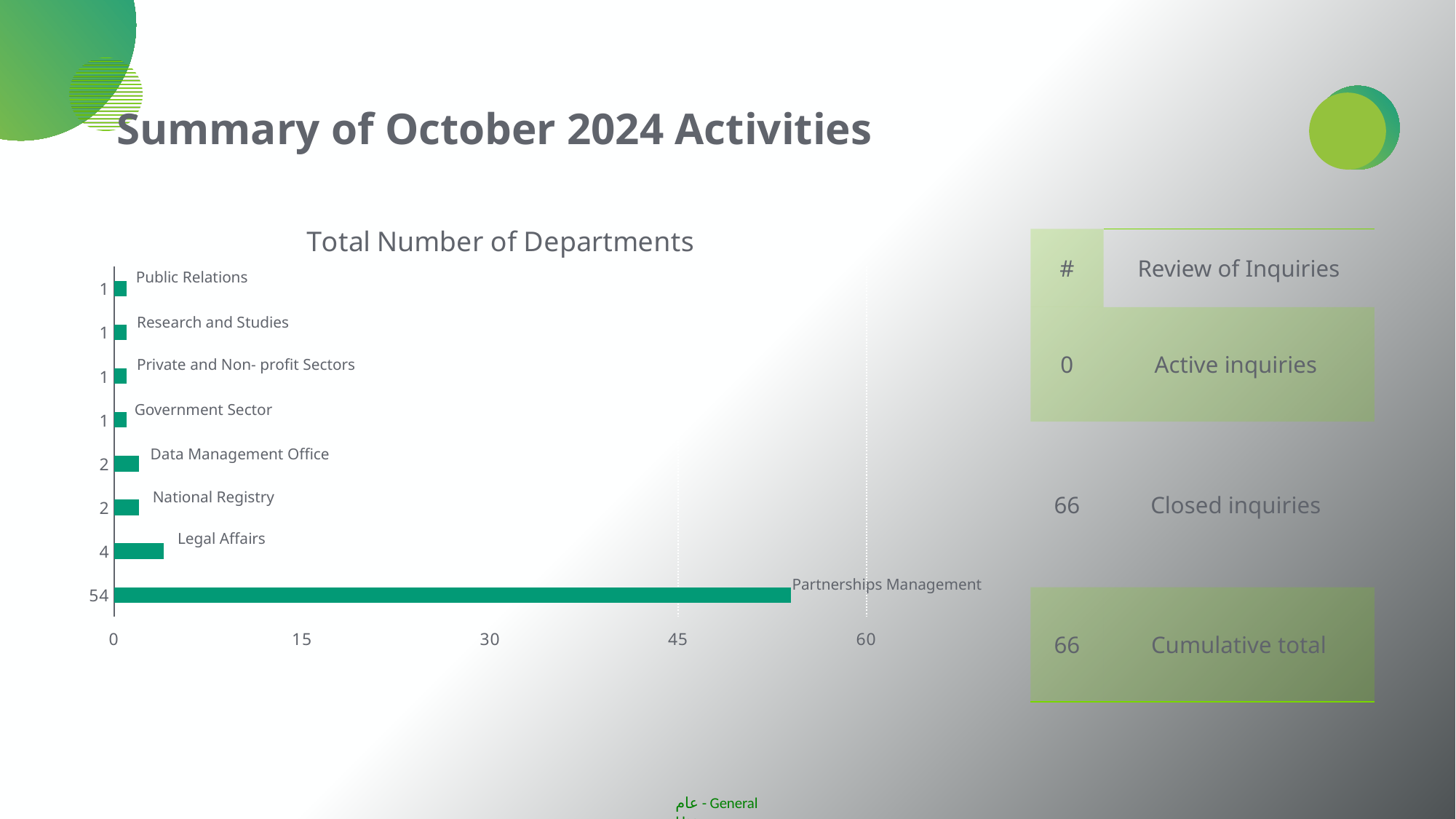
What is the value for Partnerships Management? 54 What is the value for National Registry? 2 What is the title of the chart? Total Number of Departments What kind of chart is shown on the slide? bar chart Which department has the highest value? Partnerships Management How many departments are shown in the chart? 8 What is the value for Government Sector? 1 What is the difference between the values for Partnerships Management and Legal Affairs? 50 Which is larger, the value for Legal Affairs or the value for Data Management Office? Legal Affairs What is the value for Legal Affairs? 4 Is the value for Partnerships Management greater or less than 45? greater What is the difference between the values for Data Management Office and Public Relations? 1